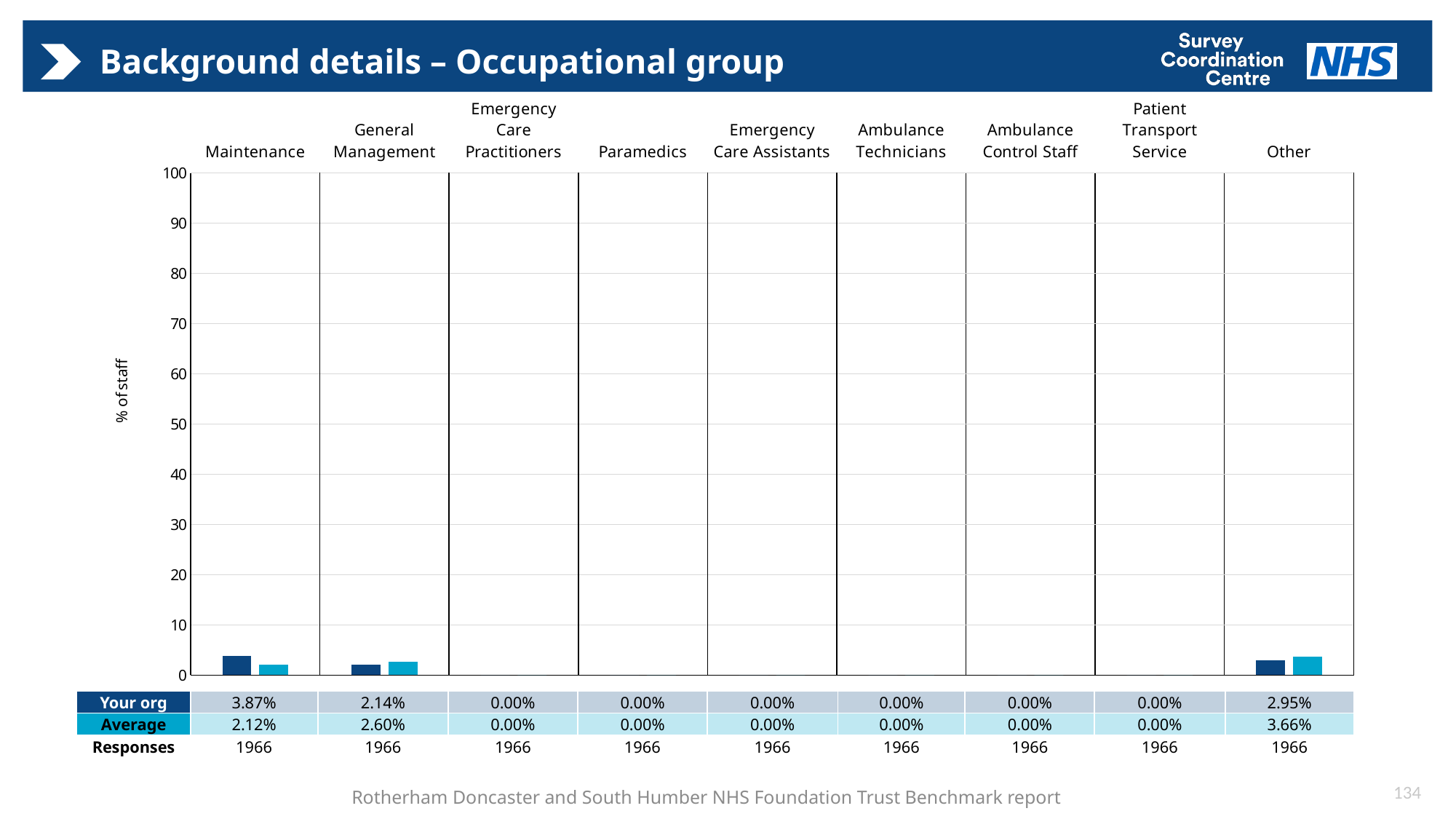
How many occupational groups are shown on the chart? 9 What type of chart is shown on the slide? Bar chart What is the Average value for Other? 3.66% Which occupational group has the highest Average value? Other What is the difference between the Your org and Average values for Maintenance? 1.75% Which occupational group has the highest Your org value? Maintenance What is the Your org value for Paramedics? 0.00% What is the Average value for General Management? 2.60% For Other, which is larger: Your org or Average? Average For General Management, which is larger: Your org or Average? Average What is the Your org value for Maintenance? 3.87% How many series does the chart show? 2